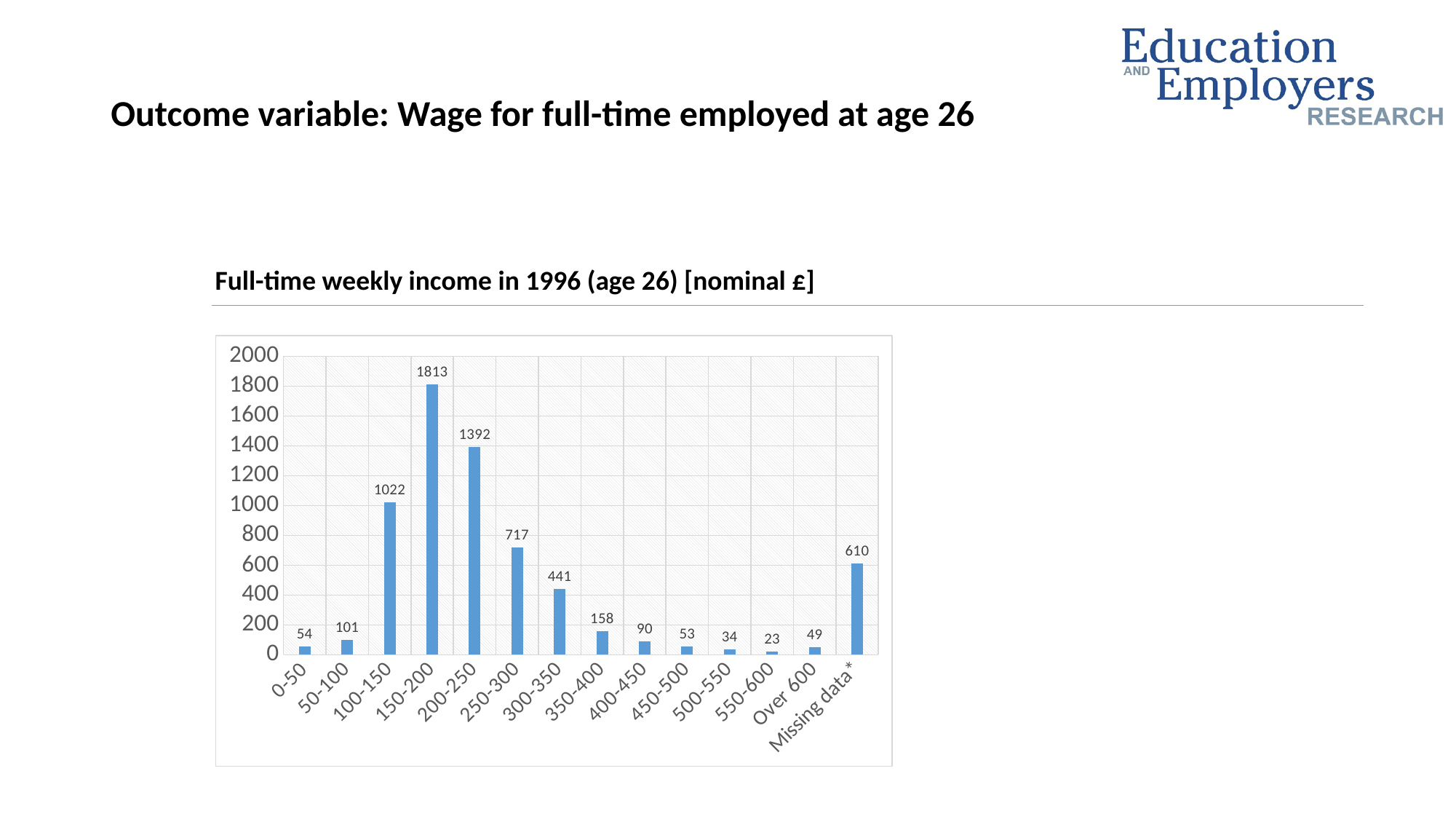
What kind of chart is shown on the slide? Bar chart What is the title of the chart? Full-time weekly income in 1996 (age 26) [nominal £] What is the value for the 150-200 category? 1813 What is the value for the Over 600 category? 49 Which category has the highest value? 150-200 What is the difference between the values for 150-200 and 200-250? 421 Which is larger, the value for 100-150 or the value for 250-300? 100-150 Which category has the lowest value? 550-600 Do the values rise or fall from 150-200 to 550-600? Fall What is the value for the Missing data* category? 610 Is the value for 300-350 greater or less than 400? greater How many categories are shown on the x axis? 14